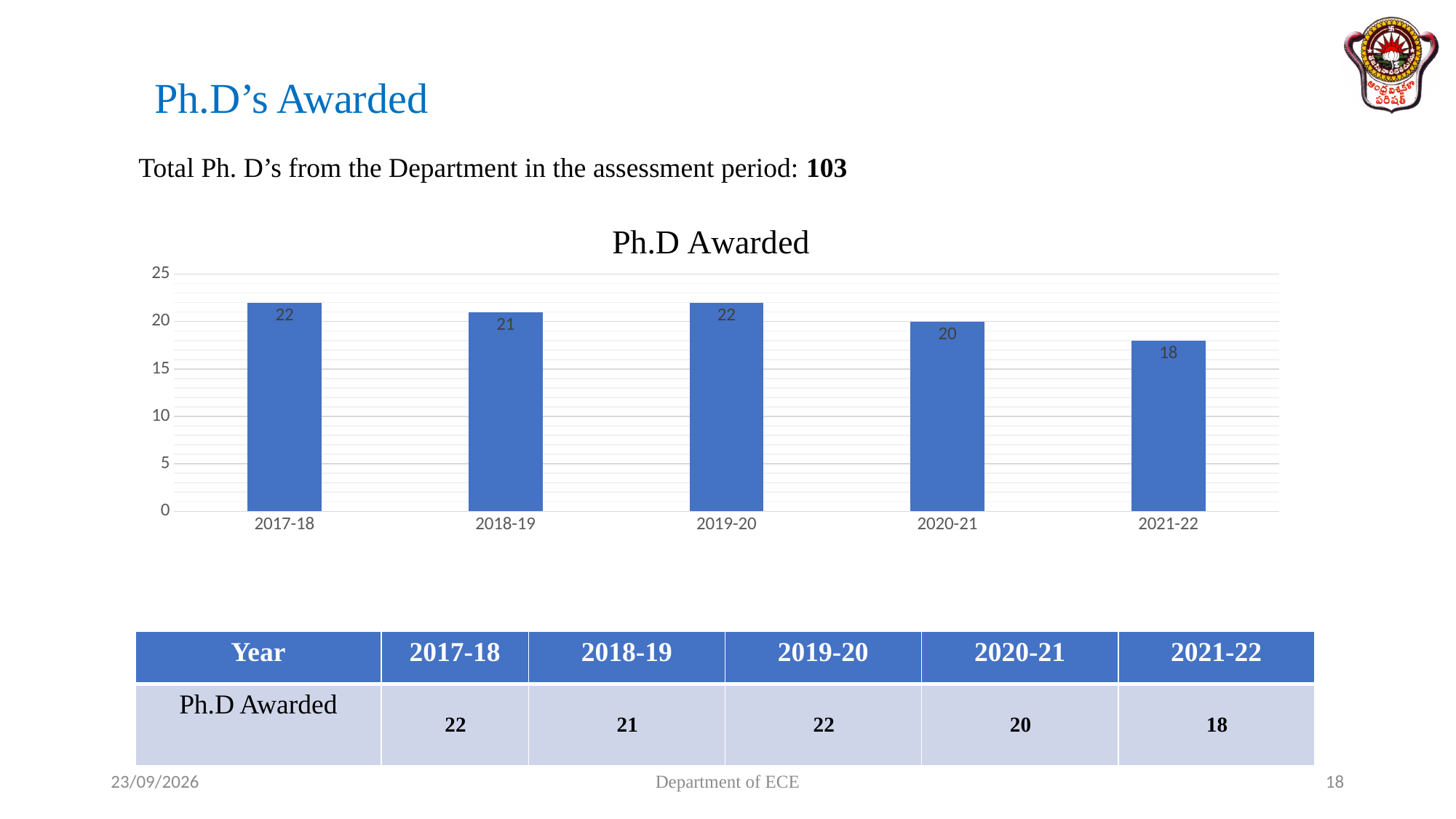
What is the value for 2020-21 in the Ph.D Awarded chart? 20 How many years are shown on the x axis of the Ph.D Awarded chart? 5 What is the difference between the values for 2017-18 and 2021-22 in the Ph.D Awarded chart? 4 What is the value for 2017-18 in the Ph.D Awarded chart? 22 Which is larger in the Ph.D Awarded chart, the value for 2018-19 or the value for 2020-21? 2018-19 Do the values in the Ph.D Awarded chart rise or fall from 2019-20 to 2021-22? fall Which year has the lowest value in the Ph.D Awarded chart? 2021-22 What is the value for 2018-19 in the Ph.D Awarded chart? 21 What kind of chart is the Ph.D Awarded chart? bar chart What is the title of the chart on the slide? Ph.D Awarded What is the value for 2021-22 in the Ph.D Awarded chart? 18 Is the value for 2021-22 in the Ph.D Awarded chart greater or less than 20? less